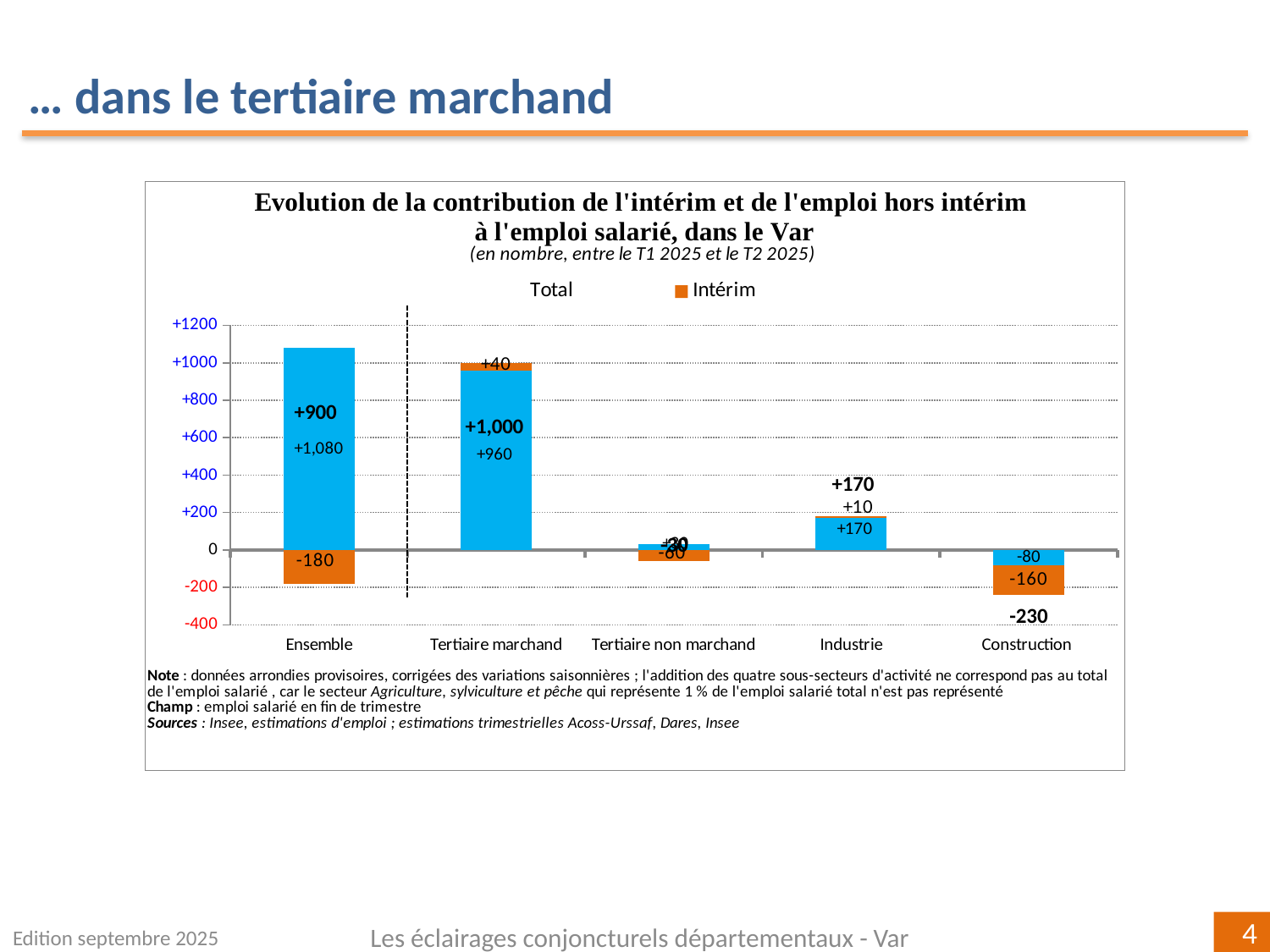
What kind of chart is shown on the slide? bar chart What is the Total value shown for Tertiaire marchand? +1,000 What is the value of the blue bar for Ensemble? +1,080 How many sector categories are shown along the x axis of the chart? 5 What is the difference between the Total value for Tertiaire marchand (+1,000) and the Total value for Ensemble (+900)? 100 Which category has the lowest Total value? Construction How many entries does the chart legend list? 2 What is the Total value shown for Construction? -230 What is the Intérim value for Construction? -160 Which category has the highest Total value? Tertiaire marchand What is the Intérim value for Ensemble? -180 What is the Intérim value for Tertiaire marchand? +40